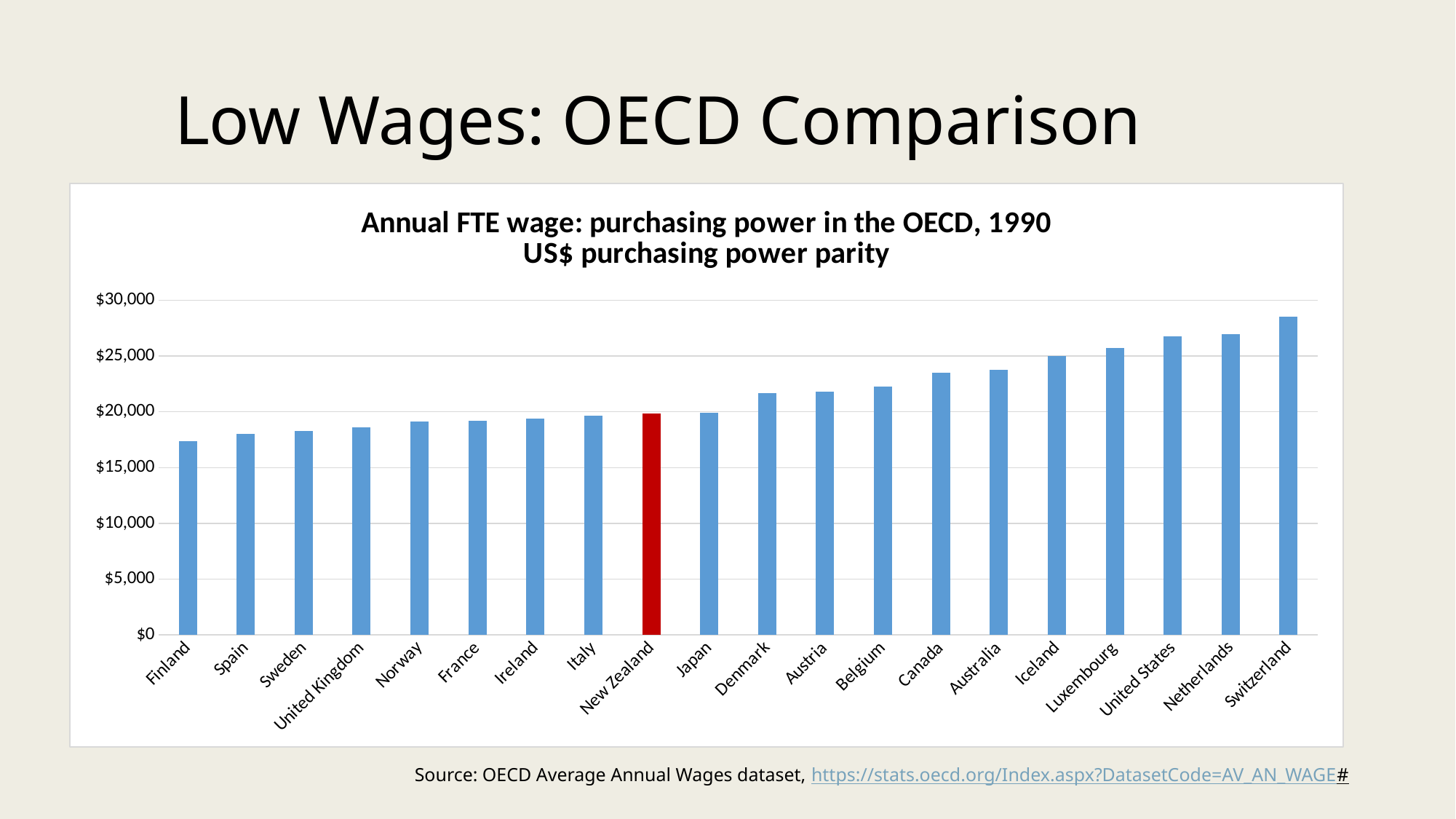
Do the values rise or fall moving from left to right along the x axis? Rise Which has the larger value, Italy or Denmark? Denmark How many countries are shown on the chart? 20 Is the value for Denmark greater or less than $20,000? greater Which country has the lowest annual FTE wage on the chart? Finland Which country has the highest annual FTE wage on the chart? Switzerland Which country's bar is highlighted in red? New Zealand Is the value for Switzerland greater or less than $25,000? greater What kind of chart is shown on the slide? Bar chart Is the value for Canada greater or less than $25,000? less Which has the larger value, Canada or Spain? Canada